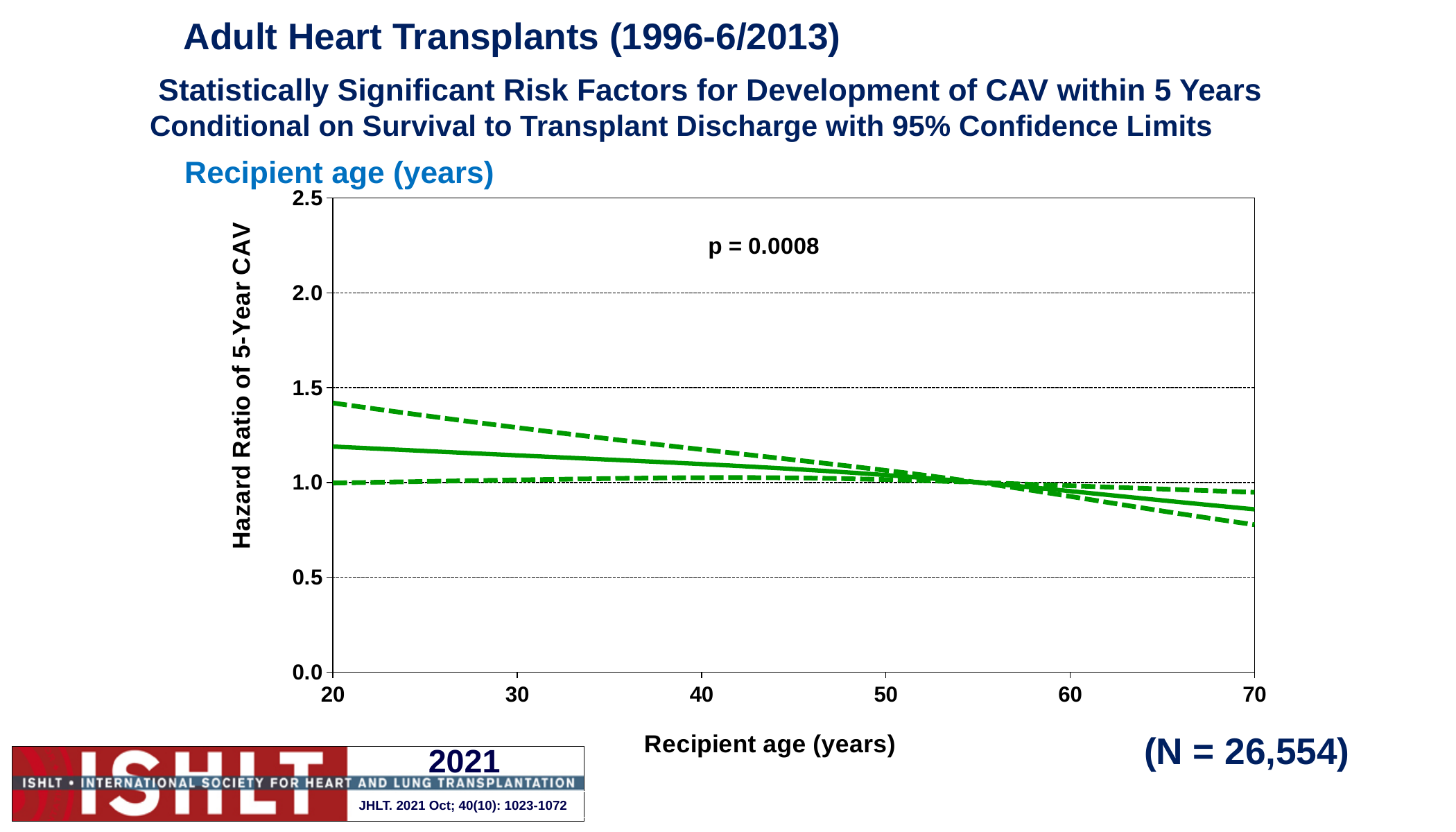
Is the upper dashed confidence limit at recipient age 20 greater or less than 1.5? less Is the lower dashed confidence limit at recipient age 70 greater or less than 0.5? greater What is the sample size (N) shown on the slide? 26,554 What range of recipient ages does the x-axis cover? 20 to 70 years What kind of chart is shown on the slide? line chart Is the hazard ratio on the solid line at recipient age 40 greater or less than 1.0? greater What is the label of the y-axis? Hazard Ratio of 5-Year CAV How many lines are plotted on the chart? 3 What is the p-value printed on the chart? p = 0.0008 Does the solid hazard ratio line rise or fall as recipient age increases from 20 to 70 years? fall